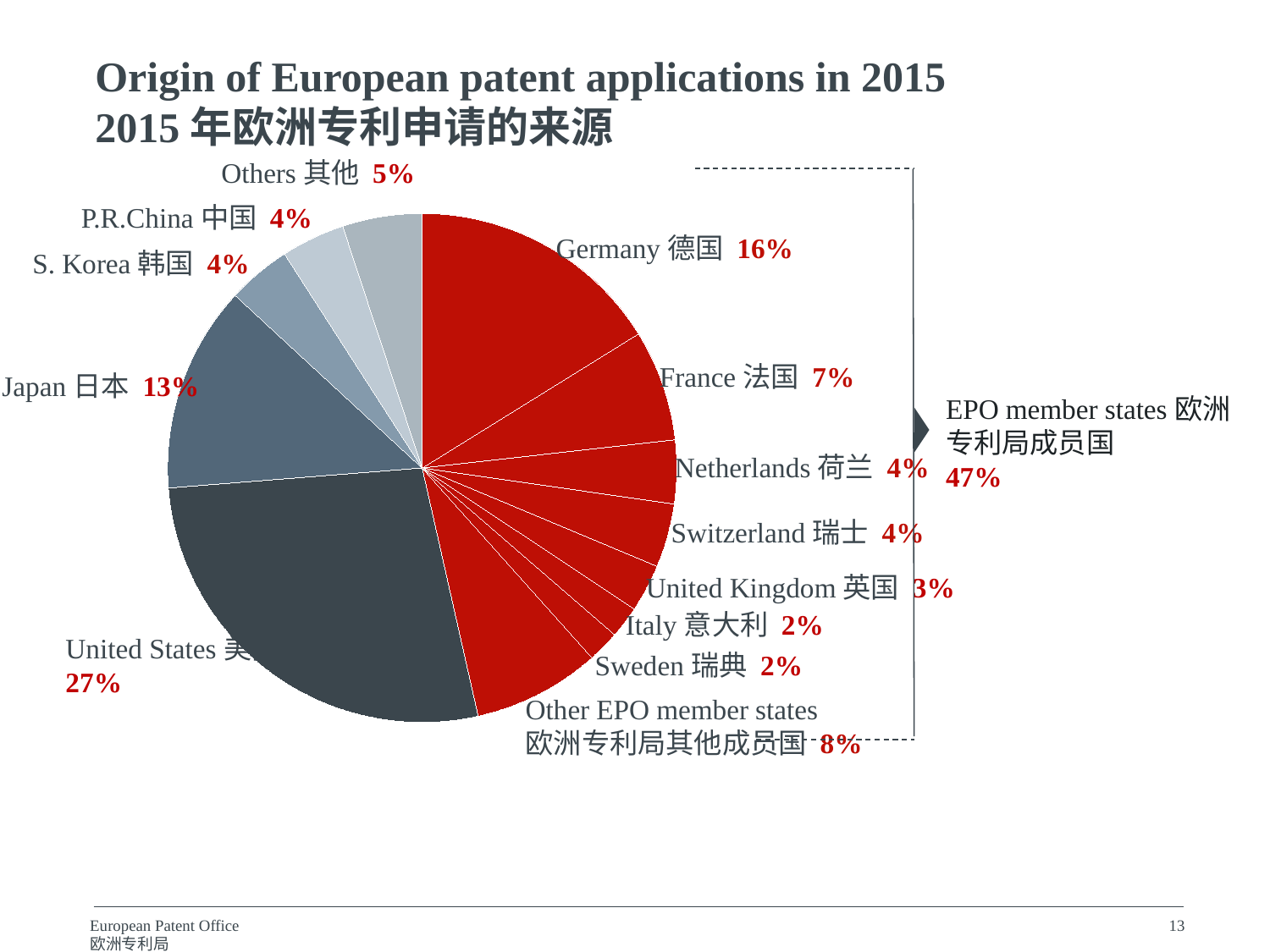
What share is shown for Other EPO member states? 8% What share of European patent applications in 2015 came from the United States? 27% What is the combined share of all EPO member states shown on the slide? 47% Which origin has the largest share of European patent applications in 2015? United States What kind of chart is shown on the slide? pie chart How many slices does the pie chart have? 13 What share of European patent applications in 2015 came from Japan? 13% What is the difference between the shares of the United States and Germany? 11% What share of European patent applications in 2015 came from P.R. China? 4% What is the title of the chart on the slide? Origin of European patent applications in 2015 What share of European patent applications in 2015 came from Germany? 16% Which has a larger share, France or Japan? Japan